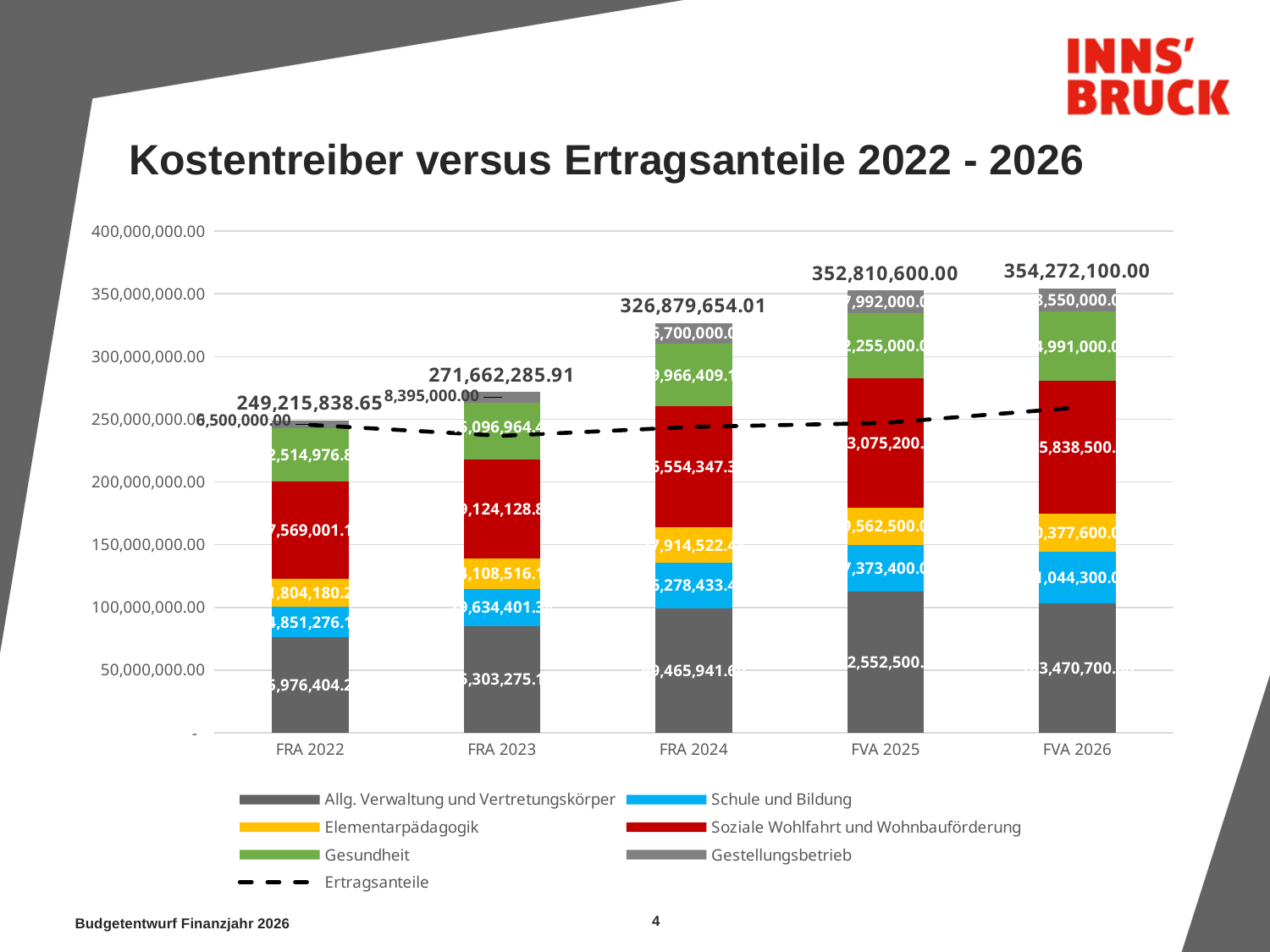
Which year has the highest total bar value? FVA 2026 What is the total value printed above the FRA 2024 bar? 326,879,654.01 What is the difference between the total for FVA 2026 and the total for FVA 2025? 1,461,500.00 Which year has the lowest total bar value? FRA 2022 Do the total bar values rise or fall from FRA 2022 to FVA 2026? rise Which is larger, the total for FRA 2023 or the total for FRA 2024? FRA 2024 What is the total value printed above the FRA 2022 bar? 249,215,838.65 What is the difference between the total for FRA 2024 and the total for FRA 2023? 55,217,368.10 How many years (categories) are shown on the x axis? 5 How many series does the legend list? 7 Is the Ertragsanteile value for FRA 2023 greater or less than 250,000,000.00? less What is the total value printed above the FVA 2025 bar? 352,810,600.00